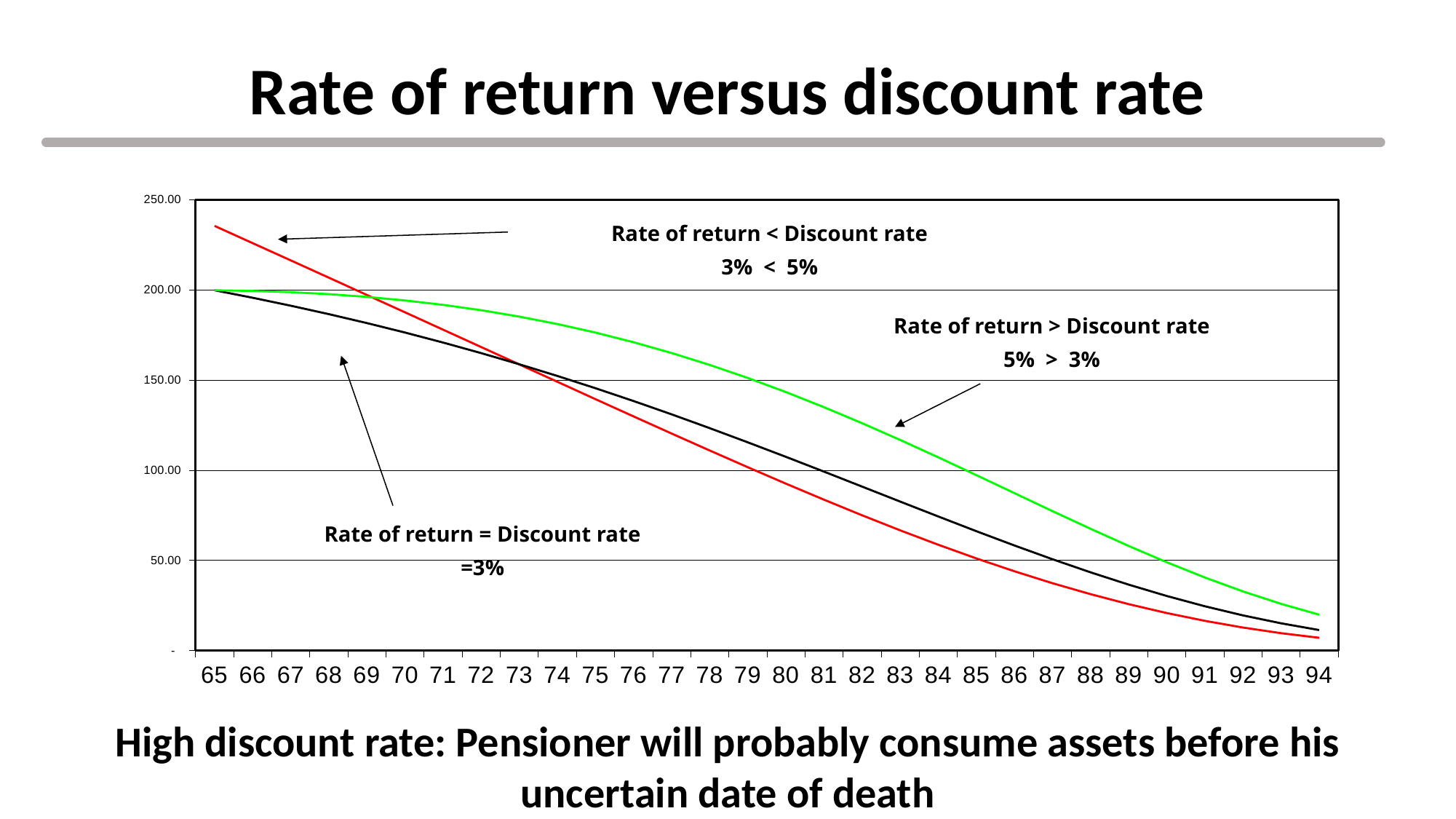
What kind of chart is shown on the slide? Line chart Is the value of the red line (Rate of return < Discount rate) at age 65 greater or less than 200? greater How many ages are shown along the x axis of the chart? 30 How many lines are plotted on the chart? 3 Which line has the highest value at age 65? Red line (Rate of return < Discount rate) At age 90, which line is higher: the green line (Rate of return > Discount rate) or the red line (Rate of return < Discount rate)? Green line (Rate of return > Discount rate) Do the values of the red line (Rate of return < Discount rate) rise or fall as age increases from 65 to 94? Fall Is the value of the green line (Rate of return > Discount rate) at age 75 greater or less than 150? greater Which line has the lowest value at age 94? Red line (Rate of return < Discount rate) Is the value of the red line (Rate of return < Discount rate) at age 85 greater or less than 100? less What is the title of the slide's chart? Rate of return versus discount rate